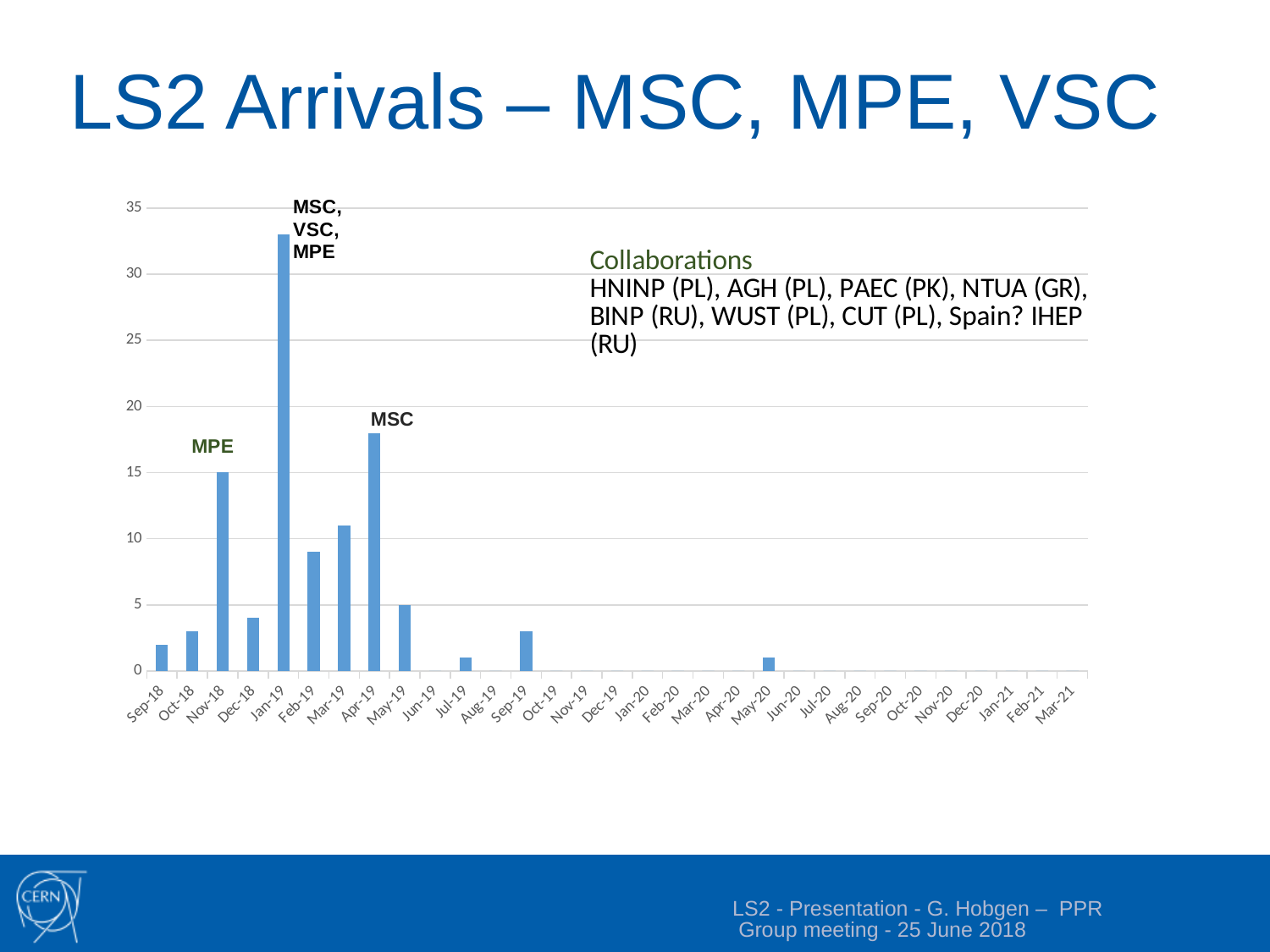
What is the value for May-19? 5 What is the difference between the values for Nov-18 and May-19? 10 Is the value for Mar-19 greater or less than 10? greater Which is larger, the value for Feb-19 or the value for Mar-19? Mar-19 Is the value for Apr-19 greater or less than 20? less What label is written above the Jan-19 bar? MSC, VSC, MPE How many months are shown on the x axis of the chart? 31 What kind of chart is shown on the slide? bar chart Is the value for Jan-19 greater or less than 30? greater What is the value for Nov-18? 15 Which is larger, the value for Nov-18 or the value for Apr-19? Apr-19 Which month has the highest bar in the chart? Jan-19